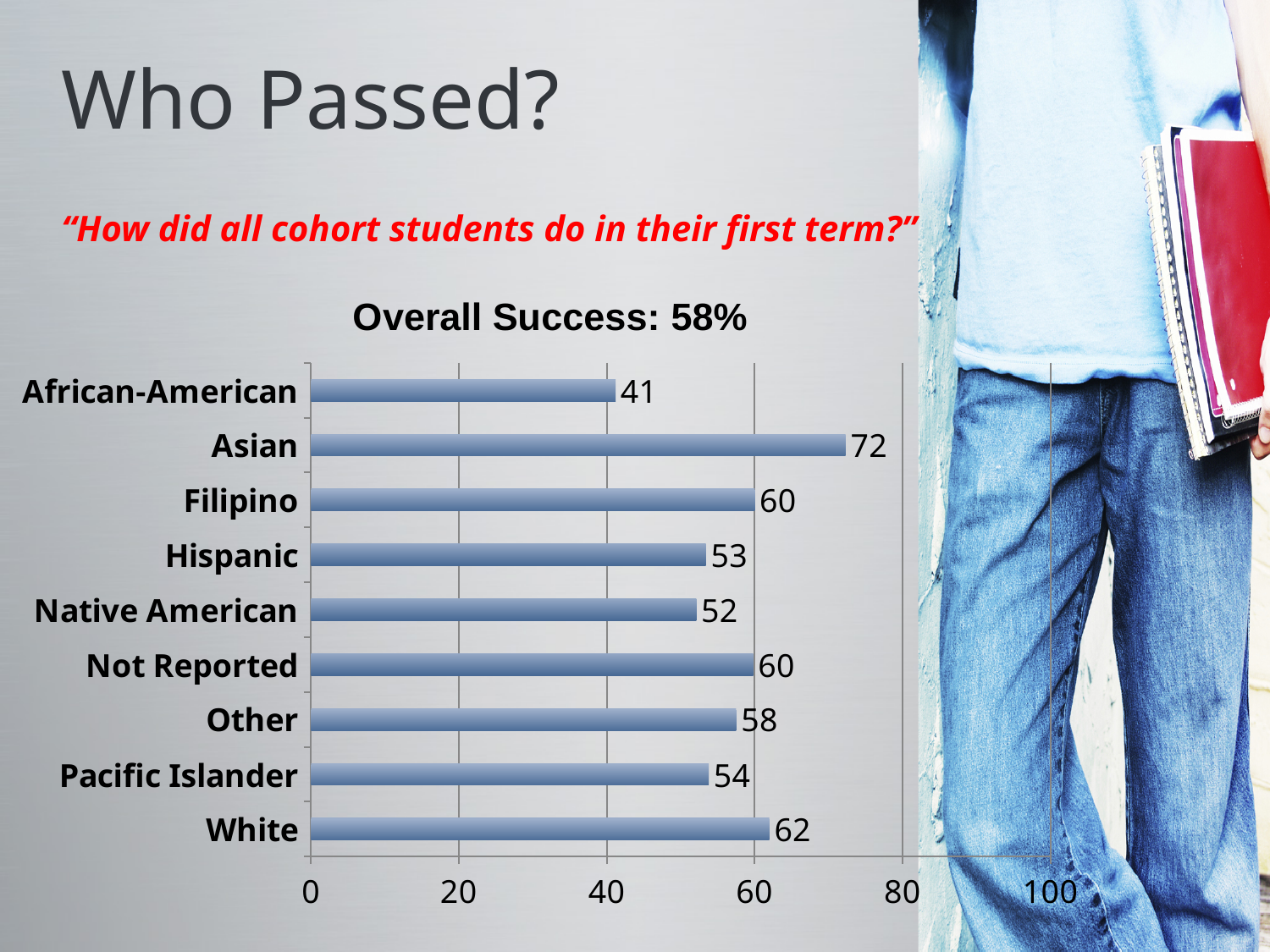
What is the value for African-American? 41 What is the difference between the values for Asian and African-American? 31 What kind of chart is shown on the slide? bar chart Which category has the highest value? Asian Is the value for Native American greater or less than 60? less What is the value for Asian? 72 What is the title of the chart? Overall Success: 58% Which is larger, the value for White or the value for Filipino? White How many categories are shown in the chart? 9 What is the value for Pacific Islander? 54 Which category has the lowest value? African-American What is the difference between the values for White and Hispanic? 9